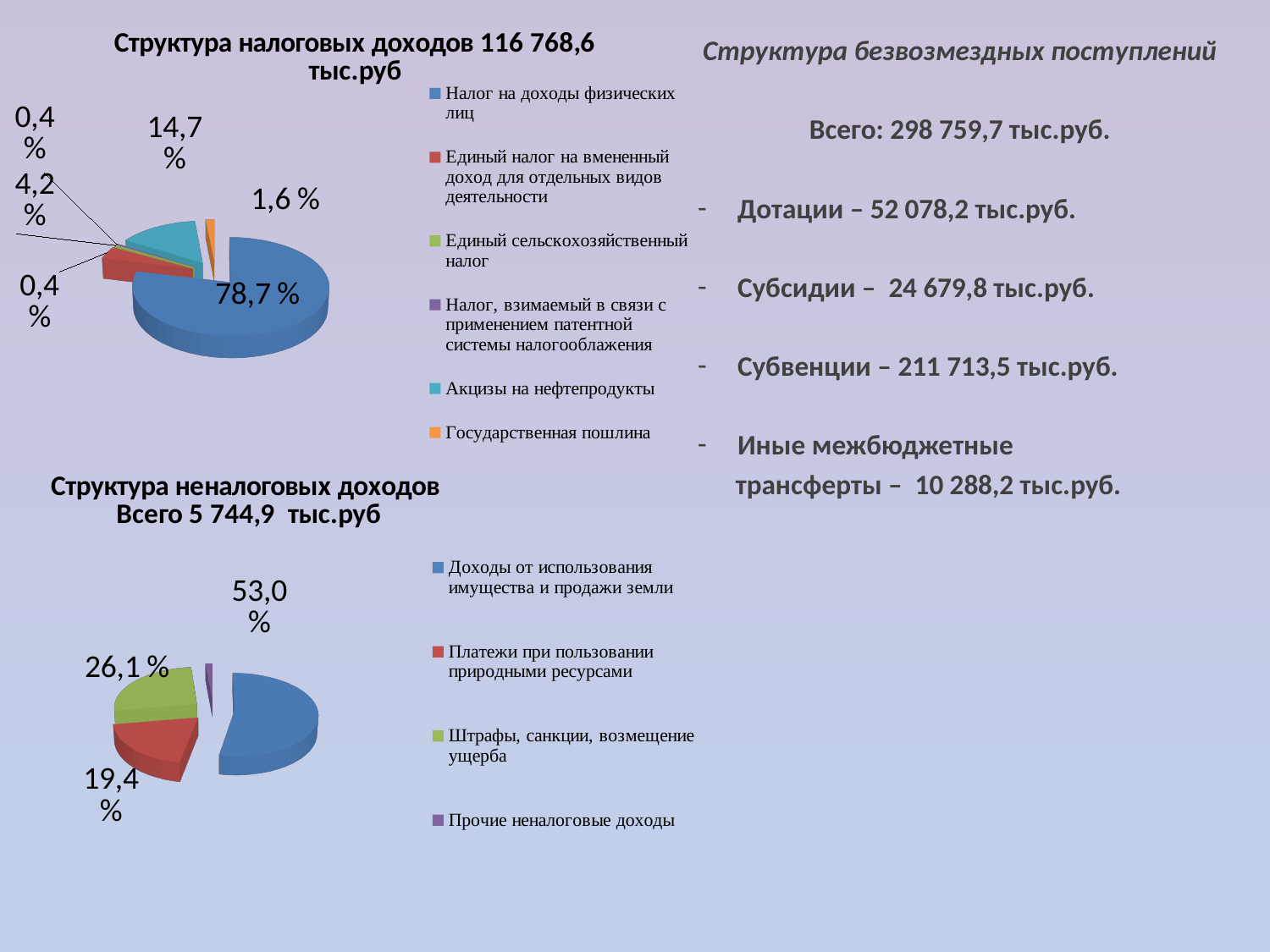
In the chart 'Структура налоговых доходов', which category has the largest share? Налог на доходы физических лиц In the chart 'Структура налоговых доходов', what share does 'Государственная пошлина' have? 1,6 % In the chart 'Структура неналоговых доходов', what share does 'Платежи при пользовании природными ресурсами' have? 19,4 % In the chart 'Структура налоговых доходов', how many categories does the legend list? 6 In the chart 'Структура неналоговых доходов', what is the difference in percentage points between 'Доходы от использования имущества и продажи земли' and 'Штрафы, санкции, возмещение ущерба'? 26,9 In the chart 'Структура налоговых доходов', what share does 'Акцизы на нефтепродукты' have? 14,7 % In the chart 'Структура неналоговых доходов', what share does 'Штрафы, санкции, возмещение ущерба' have? 26,1 % In the chart 'Структура неналоговых доходов', which category has the smallest share? Прочие неналоговые доходы In the chart 'Структура неналоговых доходов', what share does 'Доходы от использования имущества и продажи земли' have? 53,0 % In the chart 'Структура неналоговых доходов', how many categories does the legend list? 4 What type of chart is 'Структура налоговых доходов'? Pie chart In the chart 'Структура налоговых доходов', what share does 'Налог на доходы физических лиц' have? 78,7 %